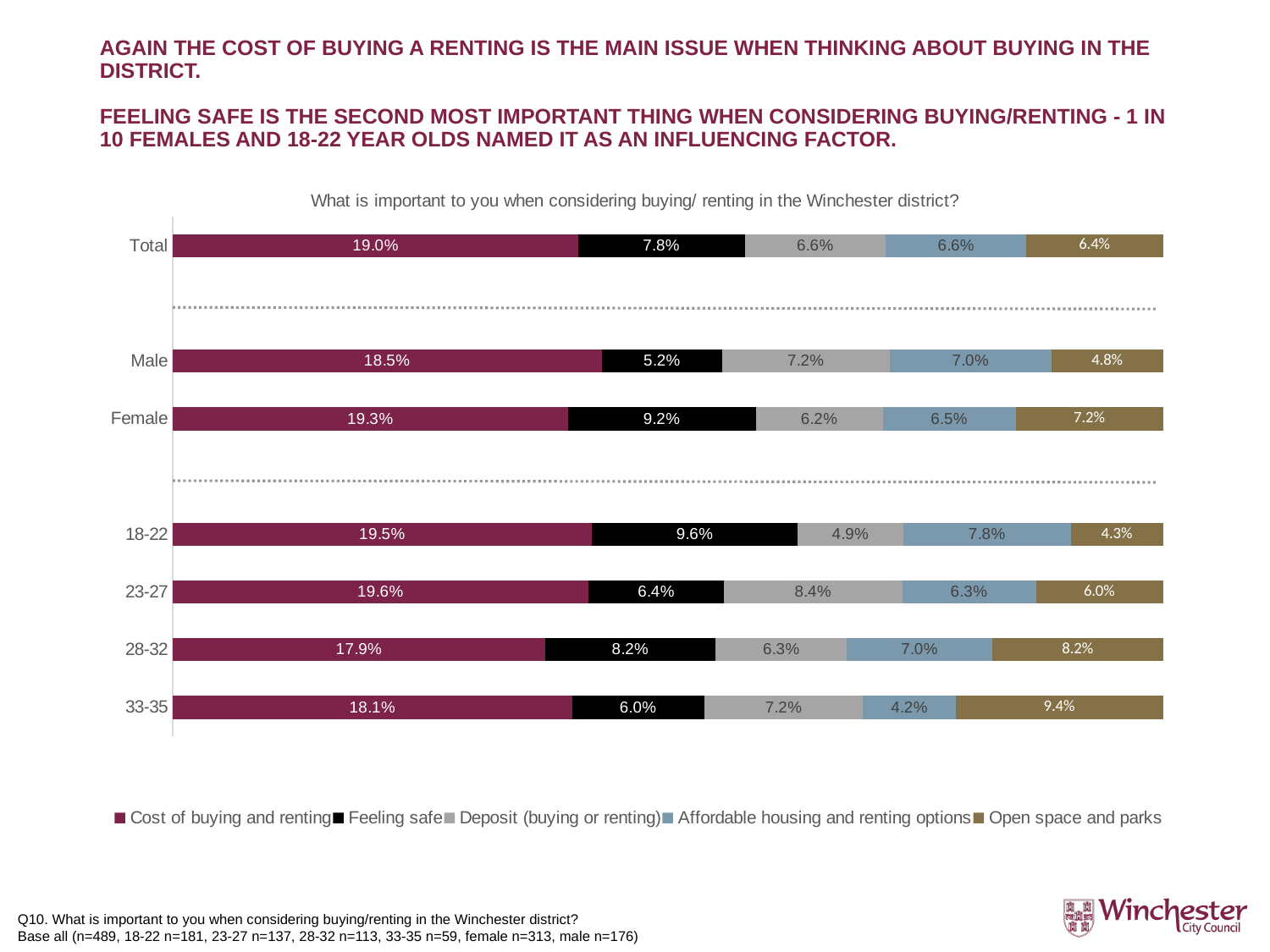
What percentage of Females named Feeling safe? 9.2% Which category has the lowest value for Feeling safe? Male What is the total of the Total bar across all five series? 46.4% What is the value for Cost of buying and renting in the Total bar? 19.0% Which category has the highest value for Open space and parks? 33-35 What is the value for Open space and parks for the 33-35 age group? 9.4% What is the title of the chart? What is important to you when considering buying/ renting in the Winchester district? What is the difference between the Female and Male values for Feeling safe? 4.0% How many series does the legend list? 5 How many categories (bars) are shown in the chart? 7 Which has a larger value for Deposit (buying or renting), Male or Female? Male What kind of chart is shown on the slide? Stacked bar chart